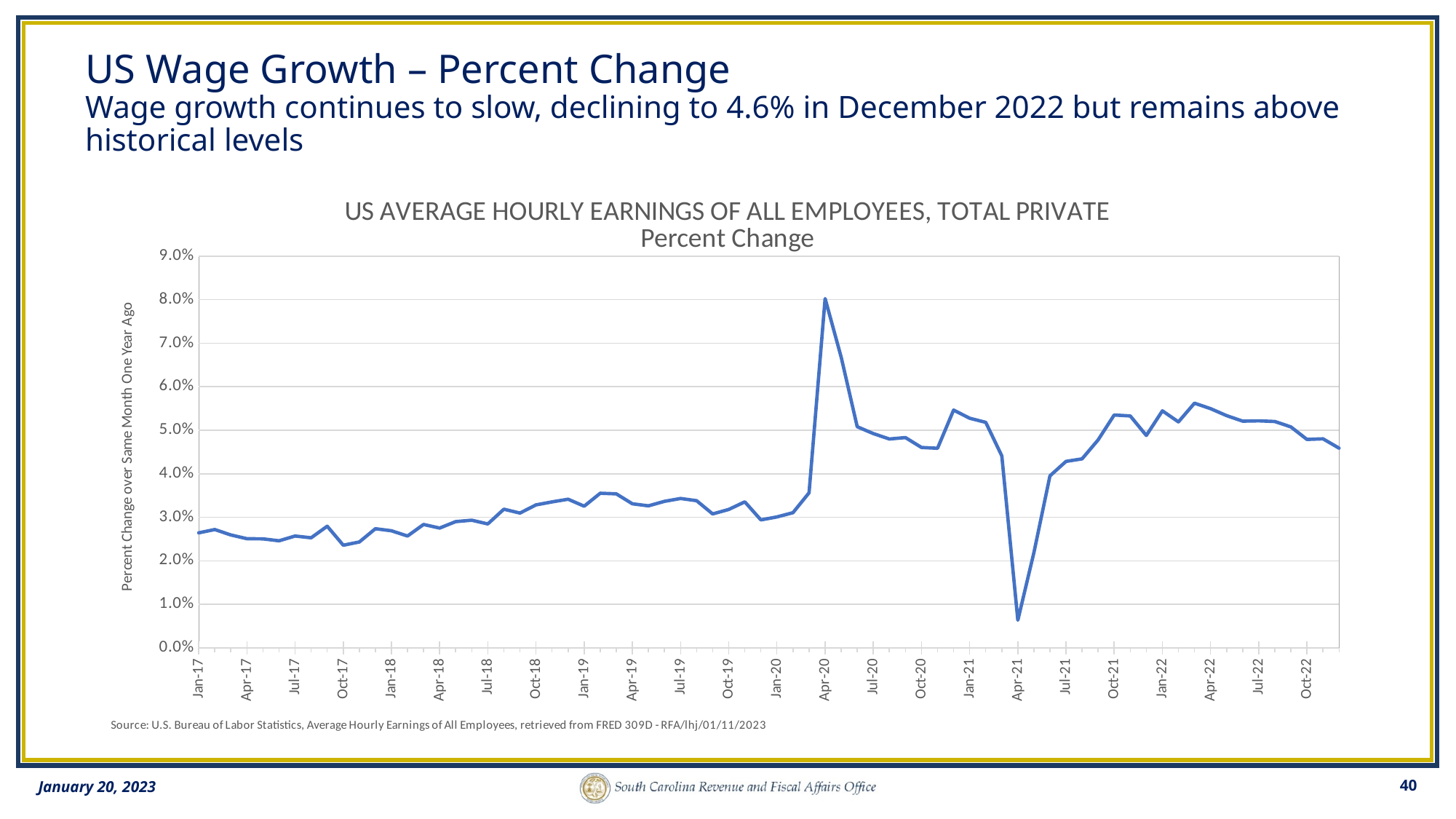
Which is larger, the value for Apr-20 or the value for Apr-21? Apr-20 Is the value for Apr-20 greater or less than 7.0%? greater Is the value for Jan-17 greater or less than 3.0%? less What kind of chart is shown on the slide? line chart What is the title of the chart? US AVERAGE HOURLY EARNINGS OF ALL EMPLOYEES, TOTAL PRIVATE Percent Change Is the value for Jan-21 greater or less than 5.0%? greater In which month does the line reach its highest value? Apr-20 According to the slide, what was the wage growth percent change in December 2022? 4.6% Does the line rise or fall between Apr-22 and the end of 2022? fall In which month does the line reach its lowest value? Apr-21 What is the label on the vertical axis of the chart? Percent Change over Same Month One Year Ago